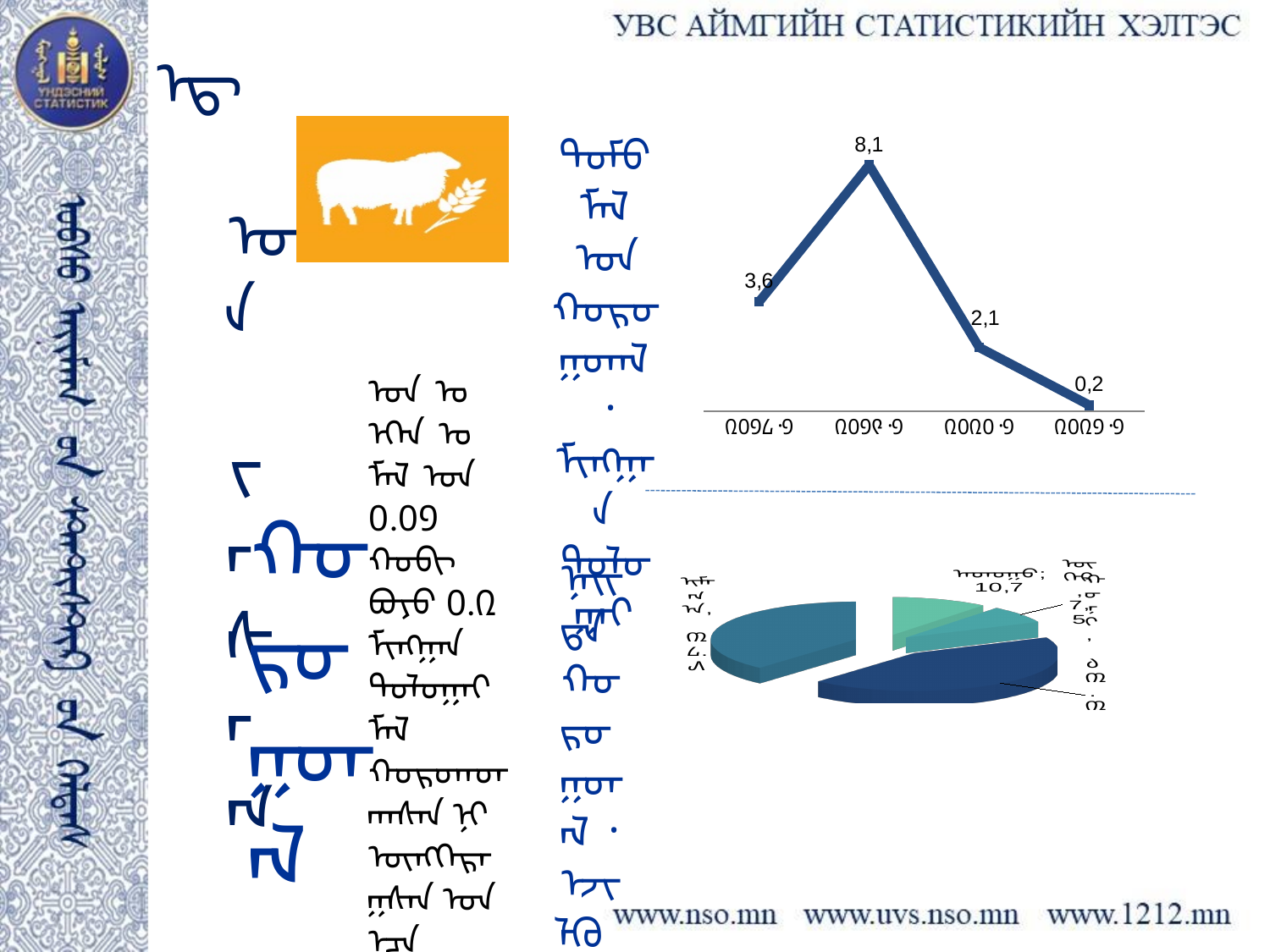
On the line chart at the top right, what is the highest value shown? 8,1 On the line chart at the top right, do the values rise or fall from the second point to the last point? fall On the line chart at the top right, what is the difference between the second point (8,1) and the first point (3,6)? 4,5 On the line chart at the top right, which is larger: the first point or the third point? the first point (3,6) On the line chart at the top right, what kind of chart is it? line chart On the line chart at the top right, what is the value of the second point? 8,1 On the line chart at the top right, what is the lowest value shown? 0,2 What kind of chart is shown at the bottom right of the slide? pie chart On the line chart at the top right, what is the value of the first (leftmost) point? 3,6 On the line chart at the top right, how many data points are plotted? 4 On the line chart at the top right, what is the value of the third point? 2,1 On the line chart at the top right, what is the value of the last (rightmost) point? 0,2